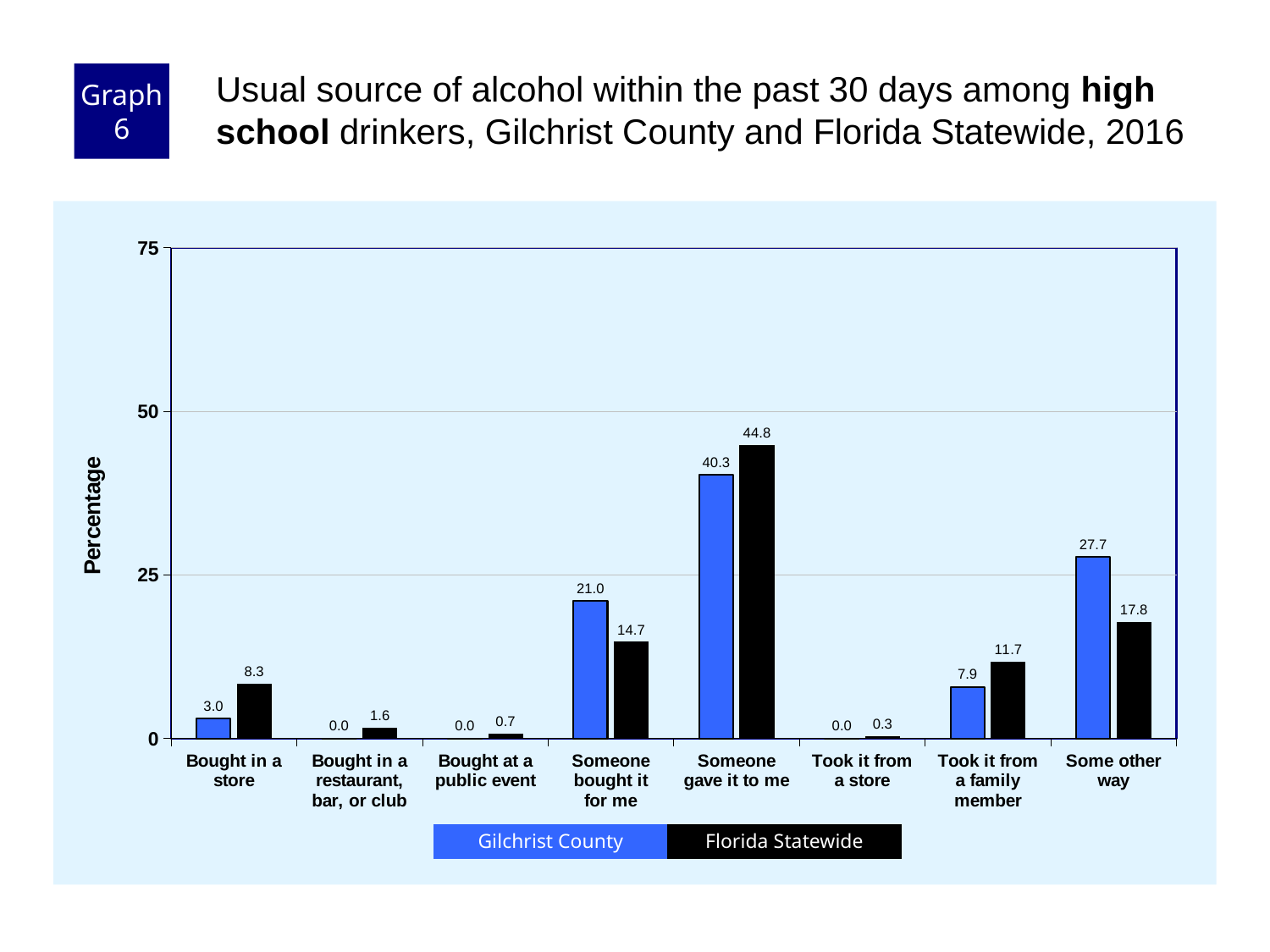
Which category has the lowest Florida Statewide value? Took it from a store Which category has the highest Florida Statewide value? Someone gave it to me What is the difference between the Florida Statewide and Gilchrist County values for "Someone gave it to me"? 4.5 Is the Gilchrist County value for "Someone bought it for me" greater or less than 25? less How many categories are shown on the x axis? 8 What is the Gilchrist County value for "Some other way"? 27.7 What is the difference between the Gilchrist County and Florida Statewide values for "Some other way"? 9.9 What is the Florida Statewide value for "Someone bought it for me"? 14.7 For "Took it from a family member", which is larger: Gilchrist County or Florida Statewide? Florida Statewide How many series does the legend list? 2 What is the Gilchrist County value for "Someone gave it to me"? 40.3 What kind of chart is shown on the slide? bar chart